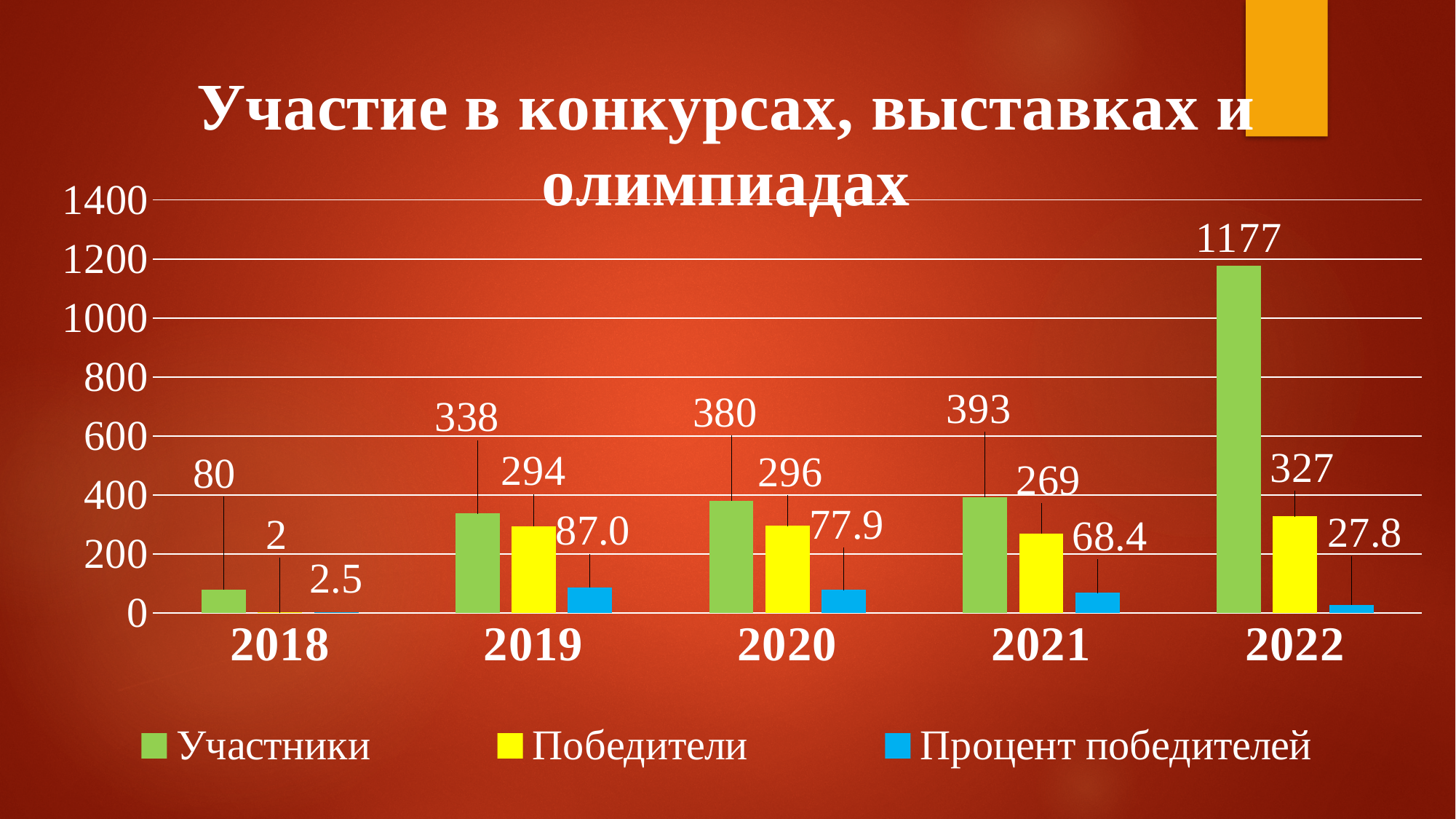
Which year has the lowest value for Процент победителей? 2018 What is the difference between Участники in 2022 and Участники in 2021? 784 What is the value for Процент победителей in 2020? 77.9 What is the value for Победители in 2018? 2 Which year has the highest value for Участники? 2022 What is the value for Победители in 2019? 294 Is the value for Участники in 2022 greater or less than 1000? greater How many years are shown on the x axis? 5 What is the value for Участники in 2022? 1177 How many series does the legend list? 3 Which is larger: Победители in 2020 or Победители in 2021? Победители in 2020 What kind of chart is shown on the slide? bar chart